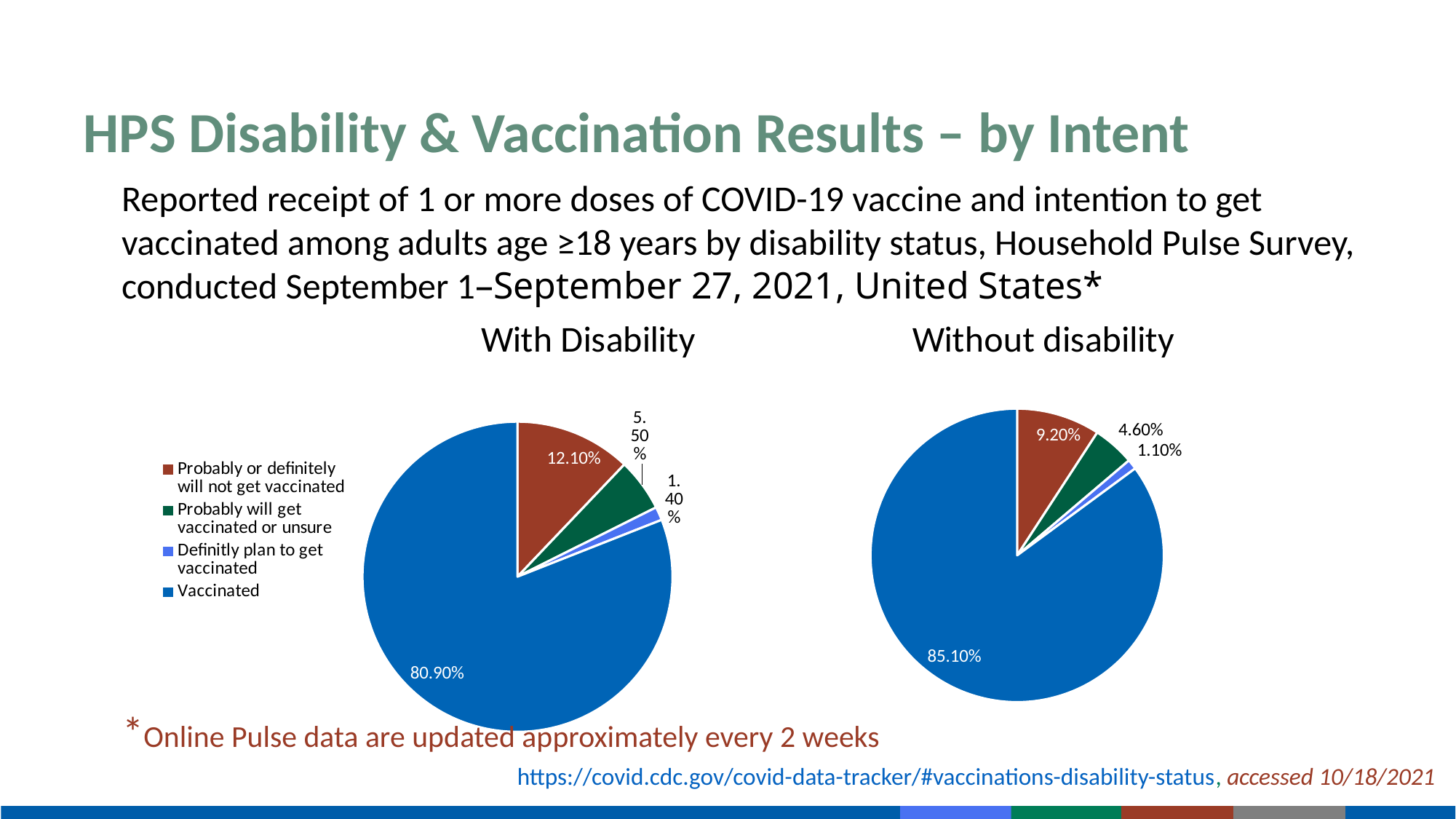
Which chart shows a larger percentage for "Probably or definitely will not get vaccinated", "With Disability" or "Without disability"? With Disability In the "Without disability" chart, which category has the smallest slice? Definitly plan to get vaccinated What is the difference between the Vaccinated percentage in the "Without disability" chart and the Vaccinated percentage in the "With Disability" chart? 4.20% What type of chart is used on this slide? Pie chart In the "With Disability" chart, which category has the largest slice? Vaccinated In the "Without disability" chart, what percentage is shown for "Probably or definitely will not get vaccinated"? 9.20% In the "Without disability" chart, what percentage is shown for "Probably will get vaccinated or unsure"? 4.60% How many categories does the legend list? 4 In the "With Disability" chart, what percentage is shown for Vaccinated? 80.90% In the "Without disability" chart, what percentage is shown for Vaccinated? 85.10% In the "Without disability" chart, what percentage is shown for "Definitly plan to get vaccinated"? 1.10% In the "With Disability" chart, what percentage is shown for "Probably or definitely will not get vaccinated"? 12.10%